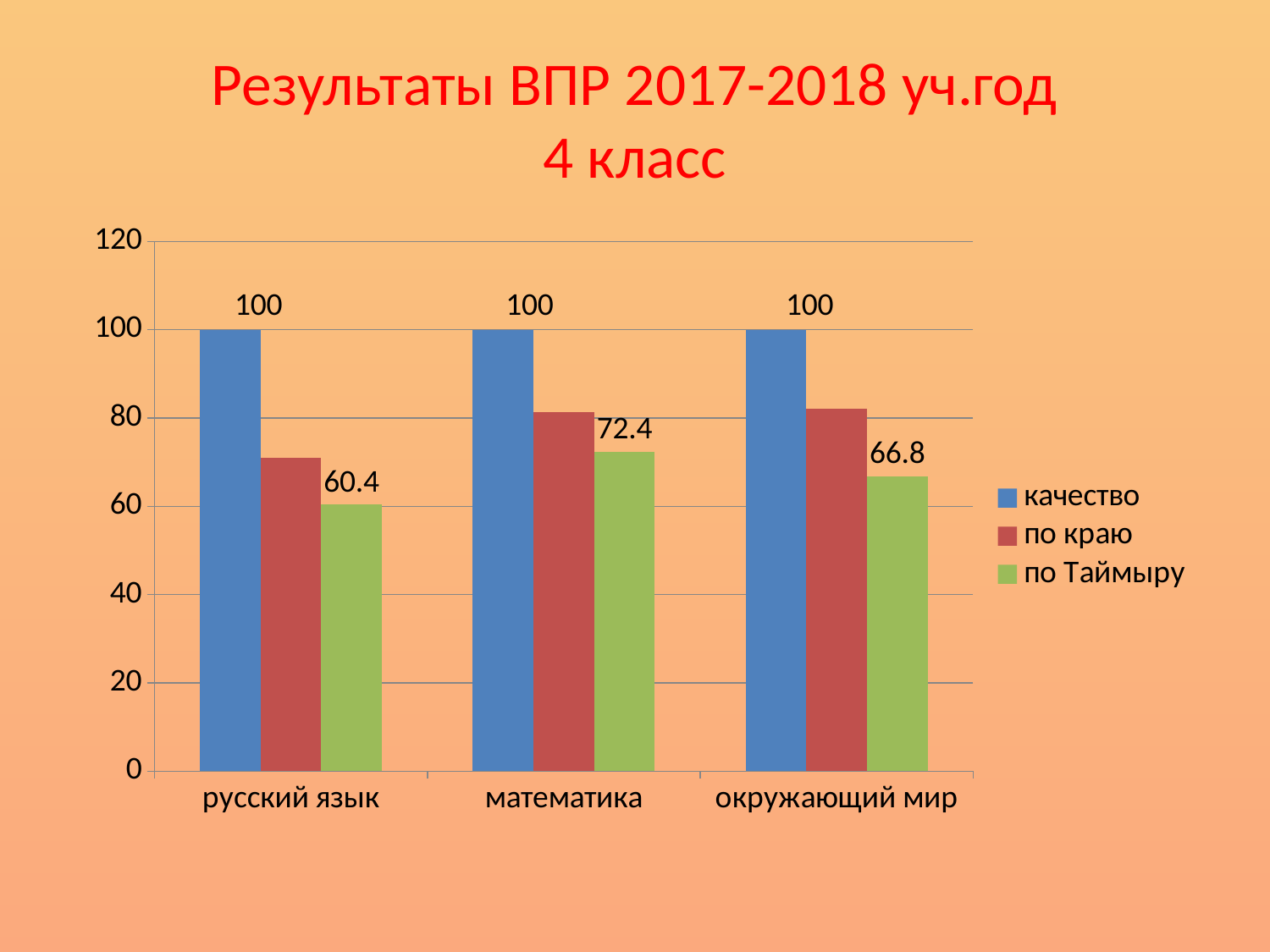
What is the value of 'качество' for 'математика'? 100 Which category has the highest value for 'по Таймыру'? математика What is the value of 'по Таймыру' for 'математика'? 72.4 What type of chart is shown on the slide? bar chart Which category has the lowest value for 'по Таймыру'? русский язык What is the value of 'по Таймыру' for 'окружающий мир'? 66.8 How many categories are shown on the x axis? 3 What is the value of 'по Таймыру' for 'русский язык'? 60.4 Is the value of 'по краю' for 'русский язык' greater or less than 80? less How many series does the legend list? 3 What is the difference between the 'по Таймыру' values for 'математика' and 'русский язык'? 12